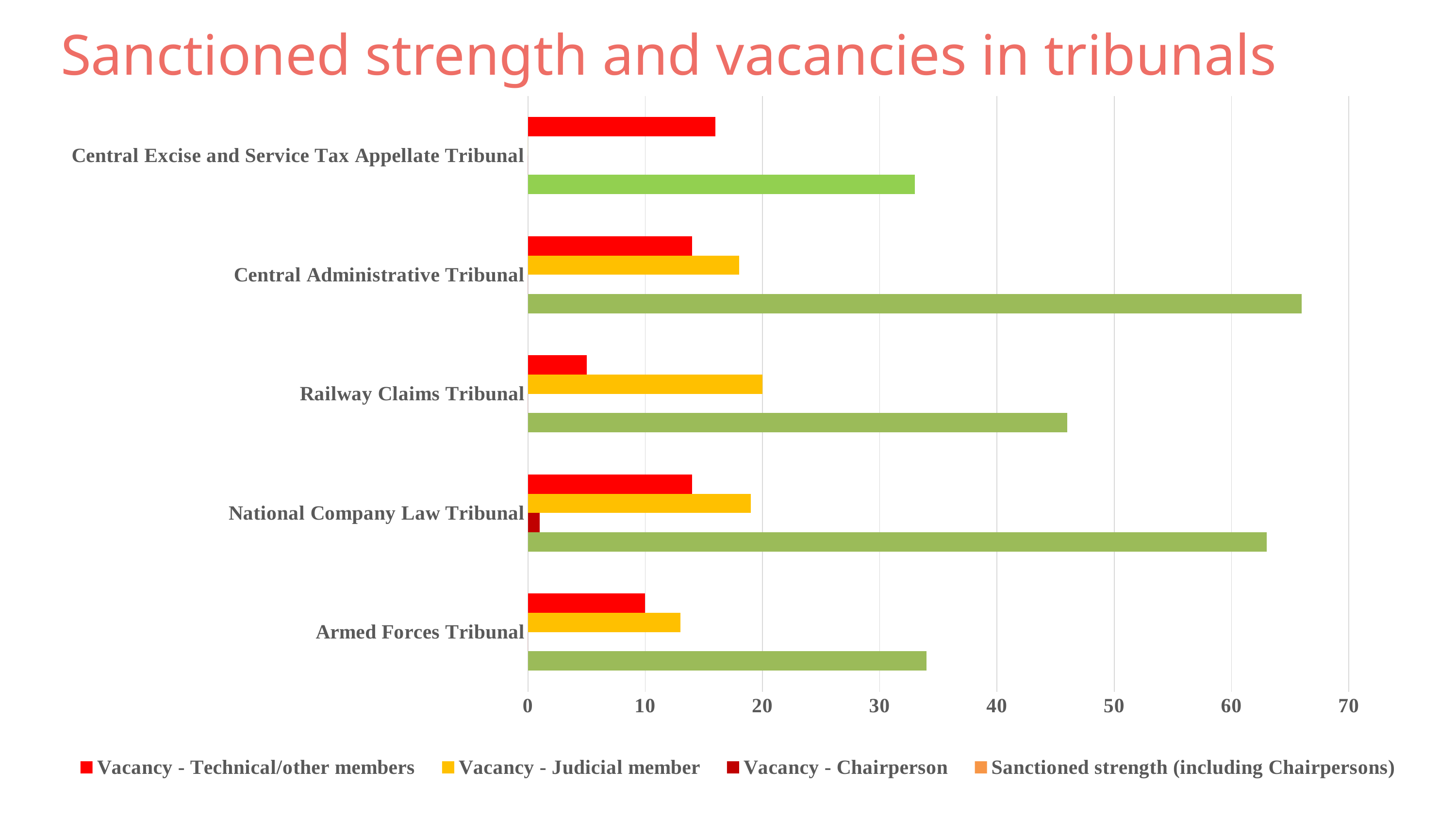
Which tribunal has the highest sanctioned strength? Central Administrative Tribunal Which tribunal has the lowest Vacancy - Technical/other members value? Railway Claims Tribunal Is the sanctioned strength for the Central Administrative Tribunal greater or less than 60? greater For the Railway Claims Tribunal, which is larger: the Vacancy - Judicial member value or the Vacancy - Technical/other members value? Vacancy - Judicial member What kind of chart is shown on the slide? bar chart What is the Vacancy - Judicial member value for the Railway Claims Tribunal? 20 Which tribunal is the only one with a Vacancy - Chairperson bar shown? National Company Law Tribunal How many series does the legend list? 4 What is the Vacancy - Technical/other members value for the Armed Forces Tribunal? 10 What is the title of the chart? Sanctioned strength and vacancies in tribunals Is the sanctioned strength for the Railway Claims Tribunal greater or less than 50? less How many tribunals are listed on the chart? 5